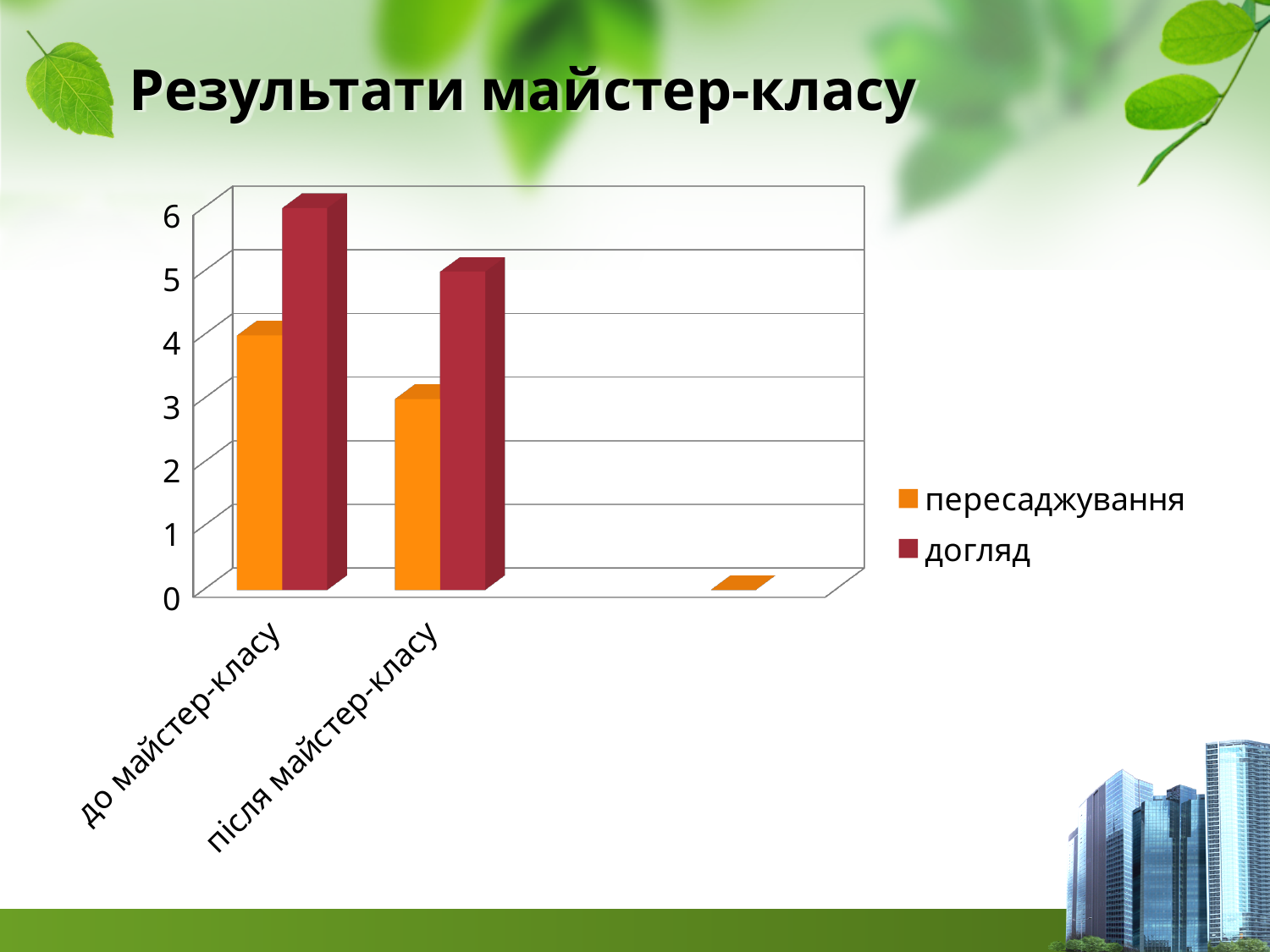
What kind of chart is shown on the slide? bar chart How many categories are labeled on the x axis? 2 Do the values of догляд rise or fall from 'до майстер-класу' to 'після майстер-класу'? fall What is the title of the slide with the chart? Результати майстер-класу Which series has the higher value for 'після майстер-класу', пересаджування or догляд? догляд Is the value of пересаджування for 'до майстер-класу' greater or less than 2? greater How many series does the chart legend list? 2 For which category is the пересаджування bar tallest? до майстер-класу Which series is shown in orange in the legend? пересаджування Is the value of пересаджування for 'після майстер-класу' greater or less than 4? less Is the value of догляд for 'до майстер-класу' greater or less than 5? greater Which series has the higher value for 'до майстер-класу', пересаджування or догляд? догляд